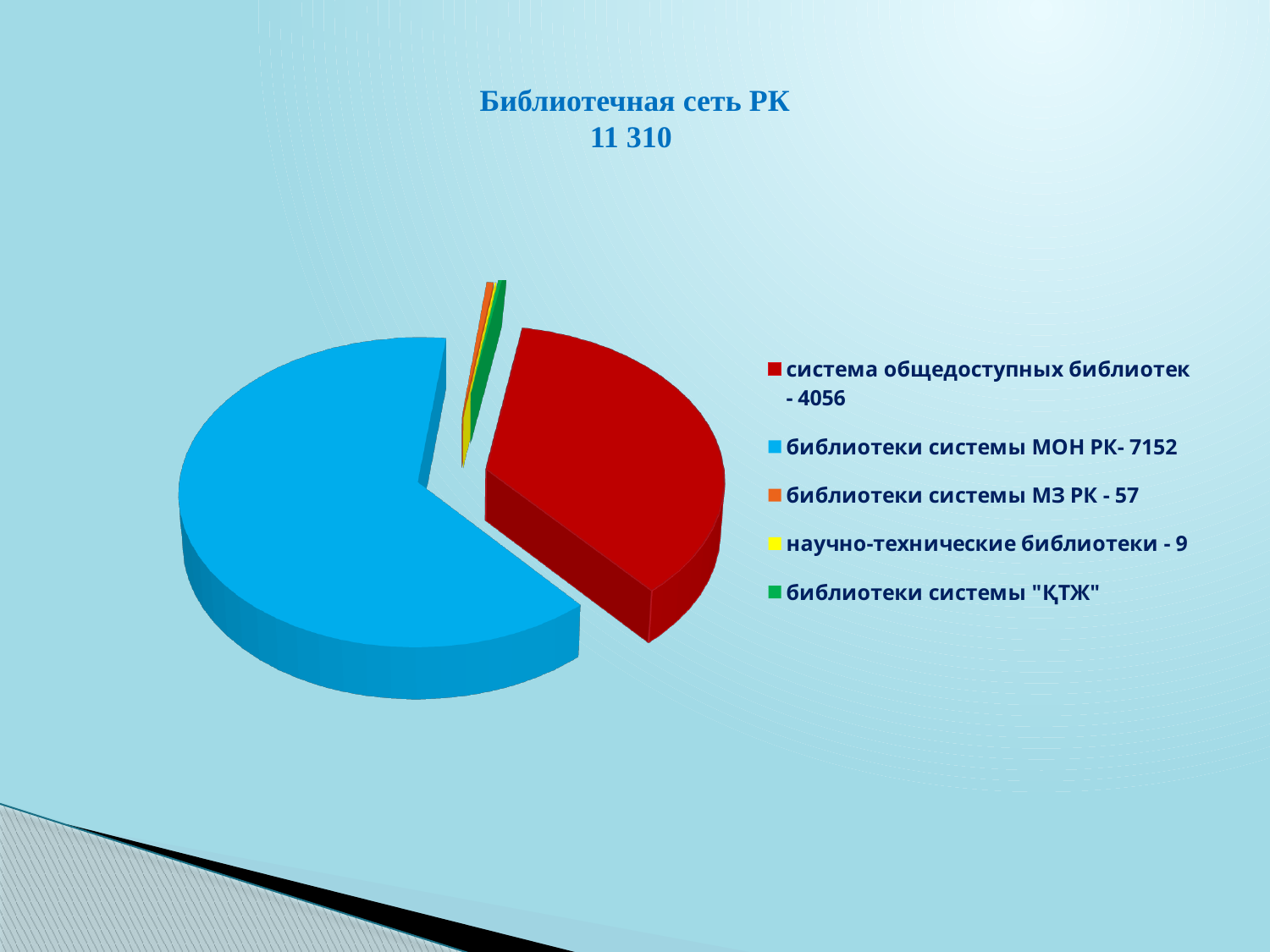
What is the value for библиотеки системы МОН РК? 7152 What is the difference between the values for библиотеки системы МЗ РК and научно-технические библиотеки? 48 What total is shown under the chart title? 11 310 What is the difference between the values for библиотеки системы МОН РК and система общедоступных библиотек? 3096 What is the value for научно-технические библиотеки? 9 Which is larger: the value for система общедоступных библиотек or the value for библиотеки системы МЗ РК? система общедоступных библиотек What is the value for система общедоступных библиотек? 4056 Which category has the largest slice of the pie? библиотеки системы МОН РК What kind of chart is shown on the slide? pie chart How many categories does the legend list? 5 What is the value for библиотеки системы МЗ РК? 57 What colour is the slice for библиотеки системы МОН РК? blue